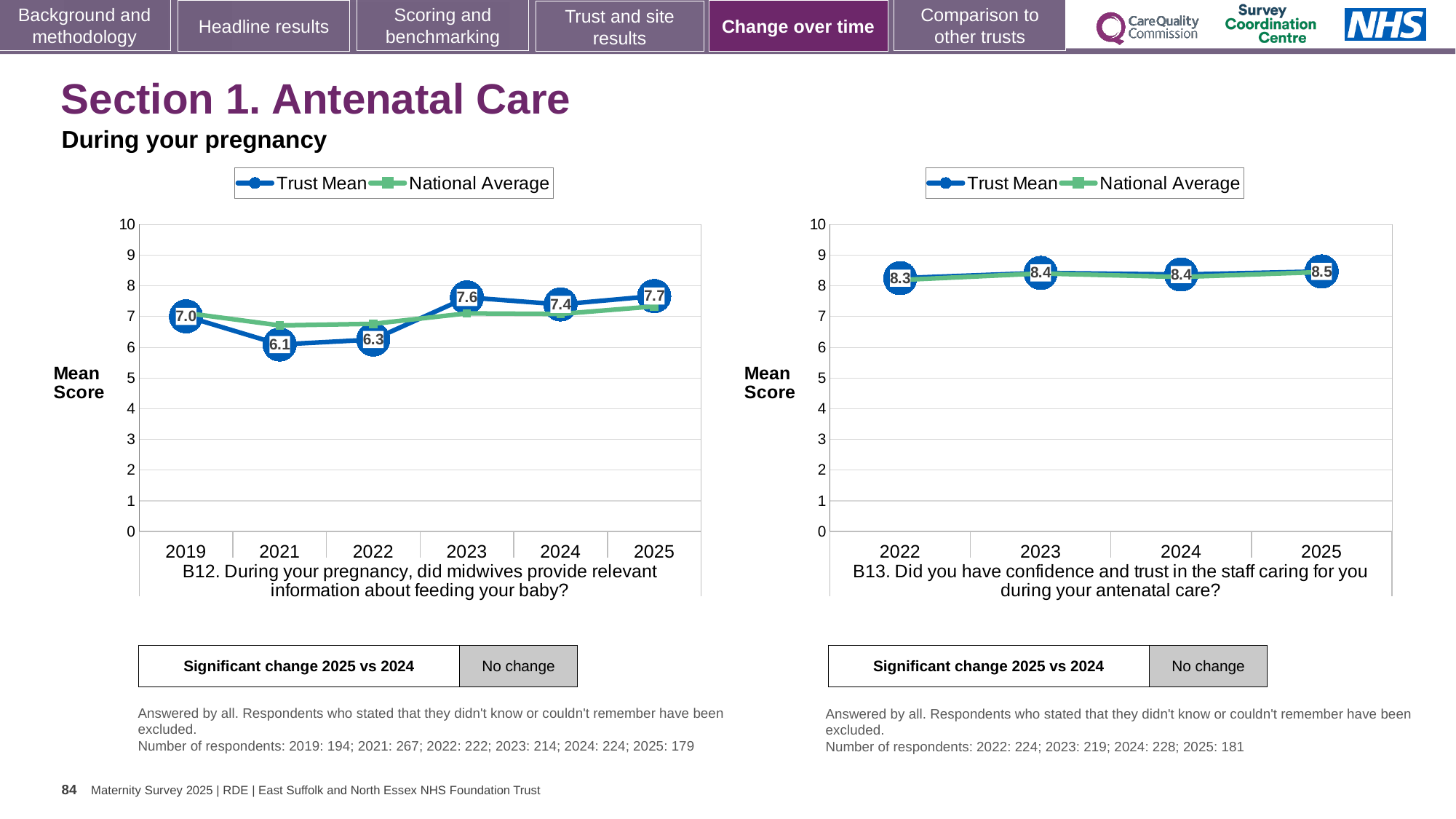
In the B12 chart (left), what is the Trust Mean score for 2021? 6.1 In the B13 chart (right), what is the Trust Mean score for 2022? 8.3 In the B12 chart (left), which year has the highest Trust Mean score? 2025 In the B12 chart (left), is the National Average for 2021 greater or less than 6? greater How many series does the legend of the B12 chart (left) list? 2 In the B12 chart (left), is the Trust Mean score for 2019 higher or lower than for 2022? higher How many years are plotted on the x axis of the B13 chart (right)? 4 What type of chart is the B13 chart (right)? line chart In the B12 chart (left), what is the difference between the Trust Mean scores for 2023 and 2021? 1.5 In the B12 chart (left), what is the Trust Mean score for 2025? 7.7 In the B13 chart (right), what is the difference between the Trust Mean scores for 2025 and 2022? 0.2 In the B12 chart (left), which year has the lowest Trust Mean score? 2021